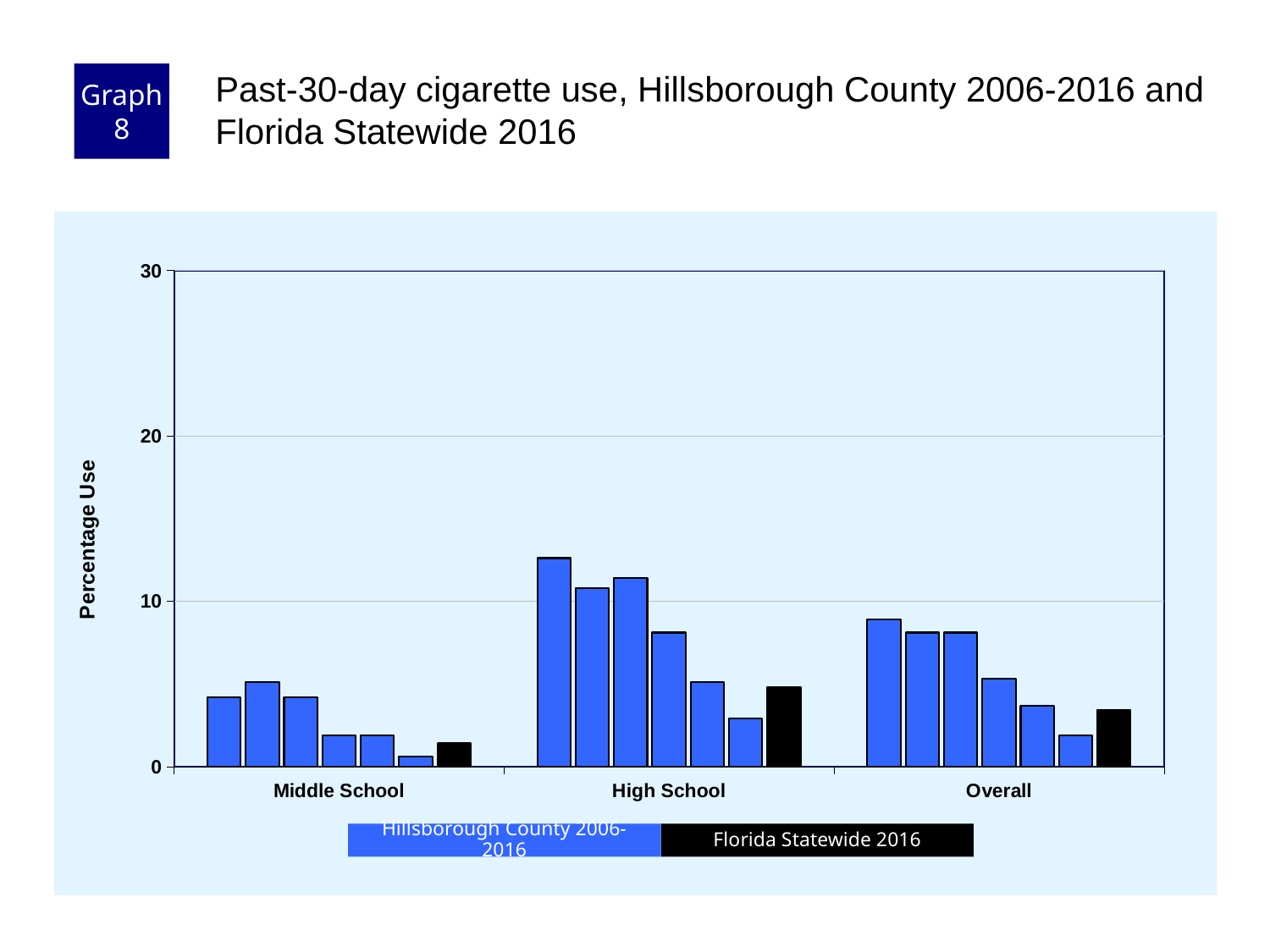
What is the label on the y axis? Percentage Use What kind of chart is shown on the slide? Bar chart Which is larger, the Florida Statewide 2016 value for High School or for Middle School? High School Is the tallest bar in the Overall group greater or less than 10? less Is the Florida Statewide 2016 value for High School greater or less than 10? less How many categories are shown on the x axis? 3 Is the tallest bar in the Middle School group greater or less than 10? less Do the Hillsborough County bars in the Overall group generally rise or fall from left to right? Fall How many series does the legend list? 2 Which category group has the highest bar overall? High School Which colour represents Florida Statewide 2016 in the legend? Black